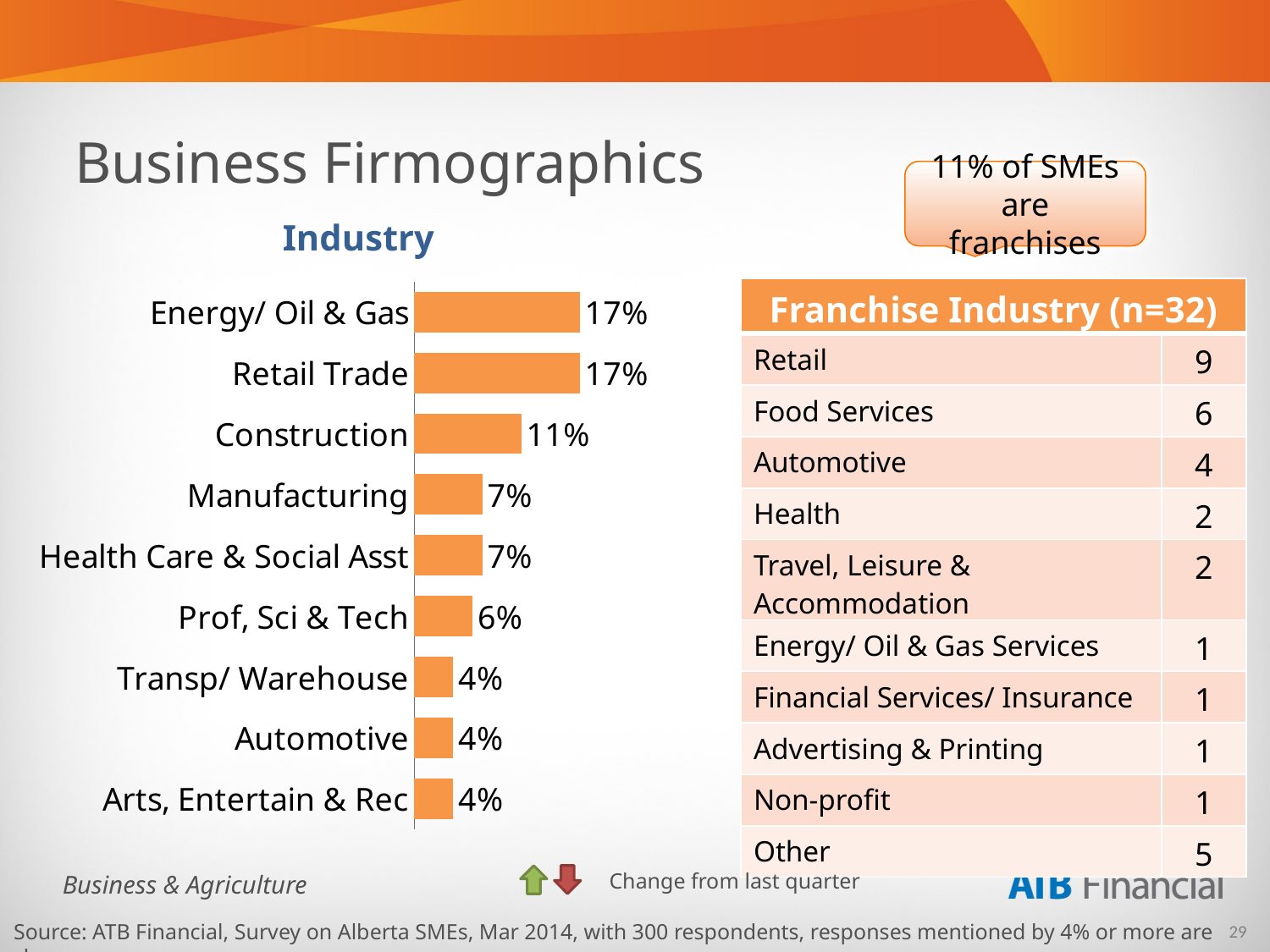
What percentage is shown for Manufacturing in the Industry chart? 7% What value is shown for Transp/ Warehouse in the Industry chart? 4% In the Industry chart, which is larger: Construction or Manufacturing? Construction How many industry categories are plotted in the Industry chart? 9 In the Industry chart, which is larger: Prof, Sci & Tech or Arts, Entertain & Rec? Prof, Sci & Tech What type of chart is the Industry chart? Bar chart In the Industry chart, what is the difference between Retail Trade and Automotive? 13 percentage points What value does the Industry chart show for Prof, Sci & Tech? 6% In the Industry chart, what is the difference between Energy/ Oil & Gas and Construction? 6 percentage points What is the highest percentage shown in the Industry chart? 17% What percentage is shown for Construction in the Industry chart? 11% What is the lowest percentage shown in the Industry chart? 4%